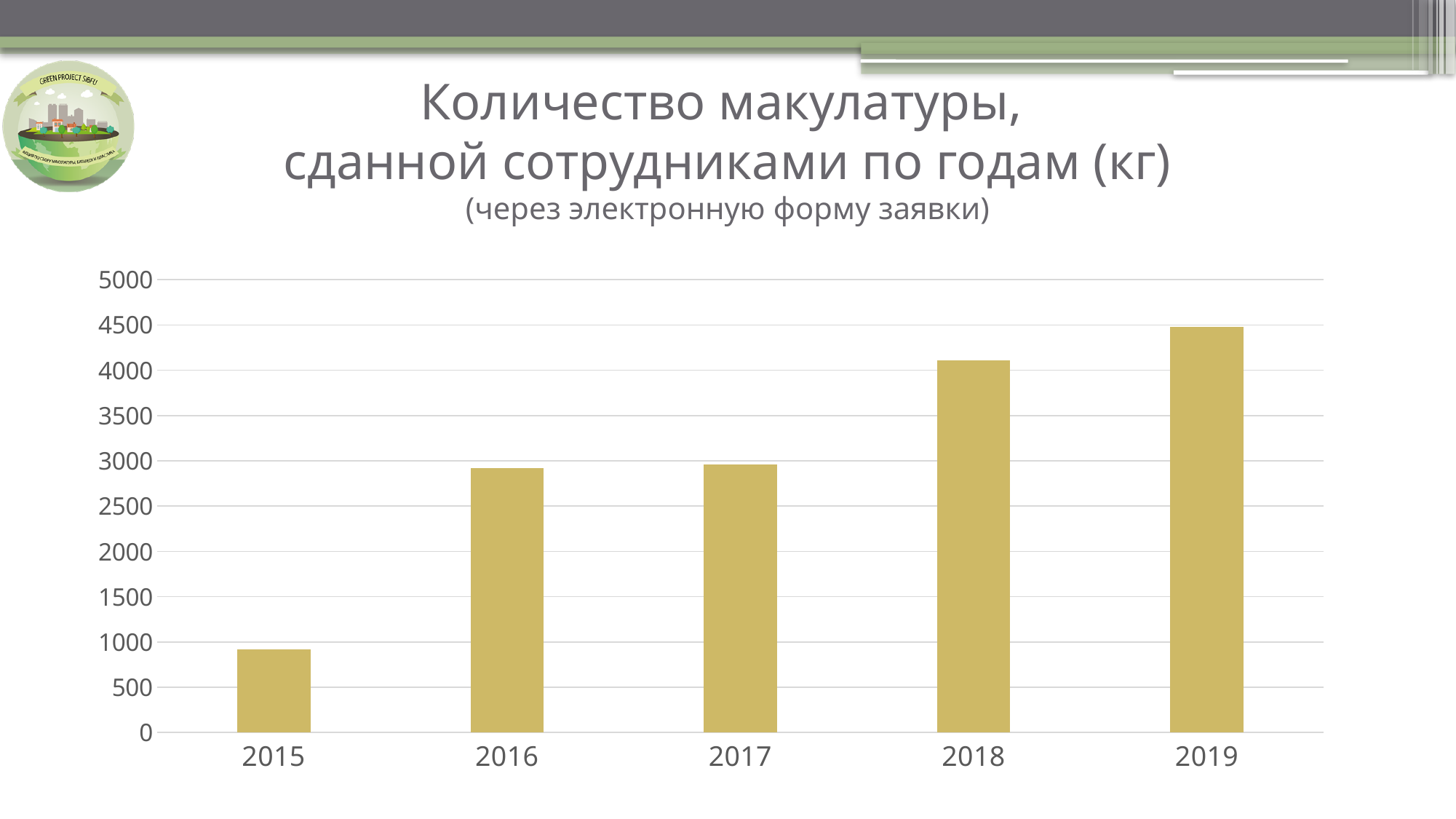
Which is larger, the value for 2015 or the value for 2017? 2017 Which year has the lowest amount of waste paper collected? 2015 Which year has the highest amount of waste paper collected? 2019 Is the value for 2015 greater or less than 1000? less How many years are shown on the x axis of the chart? 5 Is the value for 2019 greater or less than 4000? greater What kind of chart is shown on the slide? bar chart Which is larger, the value for 2016 or the value for 2018? 2018 What is the maximum value shown on the y axis of the chart? 5000 Is the value for 2017 greater or less than 2500? greater Do the values generally rise or fall from 2015 to 2019? rise